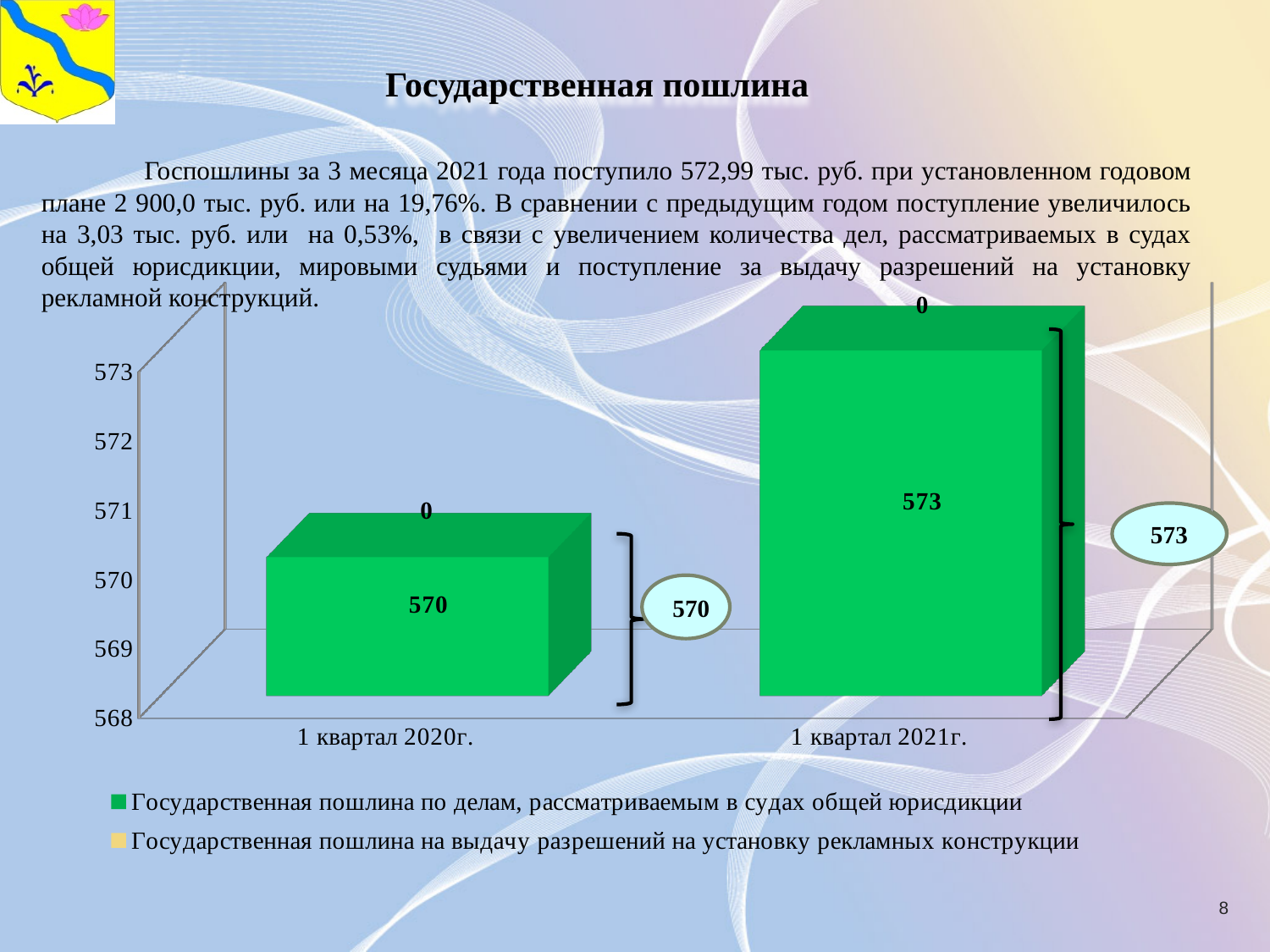
How many categories are shown on the x axis of the chart? 2 What is the value of 'Государственная пошлина на выдачу разрешений на установку рекламных конструкции' for 1 квартал 2021г.? 0 What is the total of the stacked bar for 1 квартал 2020г.? 570 Do the values rise or fall from 1 квартал 2020г. to 1 квартал 2021г.? rise What is the value of 'Государственная пошлина по делам, рассматриваемым в судах общей юрисдикции' for 1 квартал 2020г.? 570 What type of chart is shown on the slide? bar chart Which category has the higher value for 'Государственная пошлина по делам, рассматриваемым в судах общей юрисдикции'? 1 квартал 2021г. What is the value of 'Государственная пошлина по делам, рассматриваемым в судах общей юрисдикции' for 1 квартал 2021г.? 573 Is the value for 1 квартал 2020г. greater or less than 572? less What is the difference between the 1 квартал 2021г. and 1 квартал 2020г. values for 'Государственная пошлина по делам, рассматриваемым в судах общей юрисдикции'? 3 What colour represents 'Государственная пошлина по делам, рассматриваемым в судах общей юрисдикции' in the chart? green How many series does the chart legend list? 2